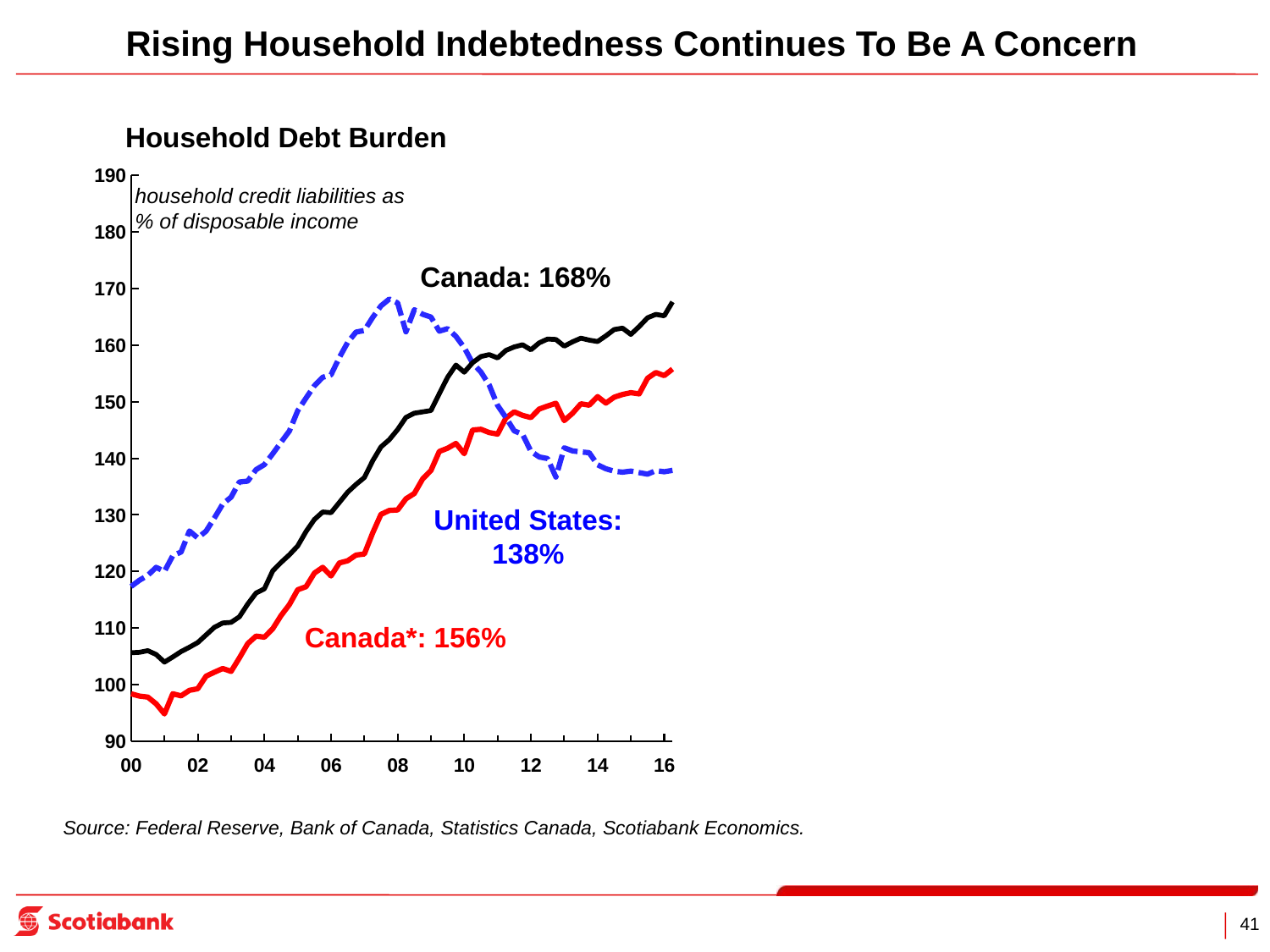
Which is larger, the labelled value for Canada or for the United States? Canada Is the peak of the United States line around 2008 greater or less than 160? greater What is the latest value shown for the United States in the Household Debt Burden chart? 138% What is the latest value shown for Canada (black line) in the Household Debt Burden chart? 168% What is the difference between the labelled values for Canada (168%) and Canada* (156%)? 12 percentage points What is the latest value shown for Canada* (red line) in the Household Debt Burden chart? 156% How many series are plotted in the Household Debt Burden chart? 3 Is the value of the black Canada line in 2004 greater or less than 130? less Which series has the lowest labelled latest value in the Household Debt Burden chart? United States Which series has the highest labelled latest value in the Household Debt Burden chart? Canada Does the United States line rise or fall between 2008 and 2016? Fall What kind of chart is the Household Debt Burden chart? Line chart